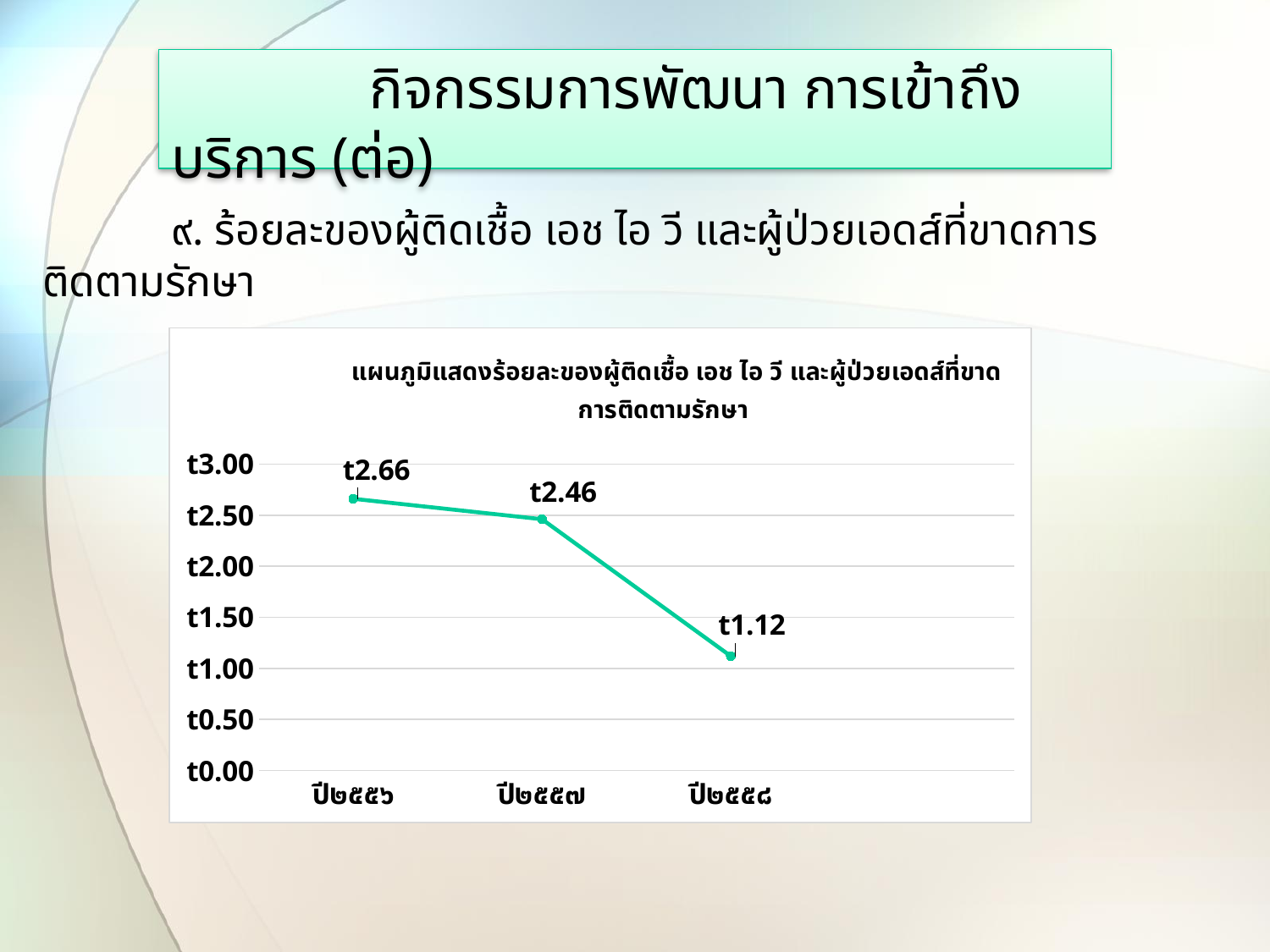
What is the value for ปี๒๕๕๖? t2.66 What is the value for ปี๒๕๕๘? t1.12 Do the values rise or fall from ปี๒๕๕๖ to ปี๒๕๕๘? fall How many years are plotted on the chart? 3 What is the difference between the values for ปี๒๕๕๖ and ปี๒๕๕๗? t0.20 Which is larger, the value for ปี๒๕๕๖ or the value for ปี๒๕๕๘? ปี๒๕๕๖ Is the value for ปี๒๕๕๘ greater or less than t1.50? less What kind of chart is shown on the slide? line chart What is the difference between the values for ปี๒๕๕๗ and ปี๒๕๕๘? t1.34 Which year has the highest value? ปี๒๕๕๖ Which year has the lowest value? ปี๒๕๕๘ What is the value for ปี๒๕๕๗? t2.46